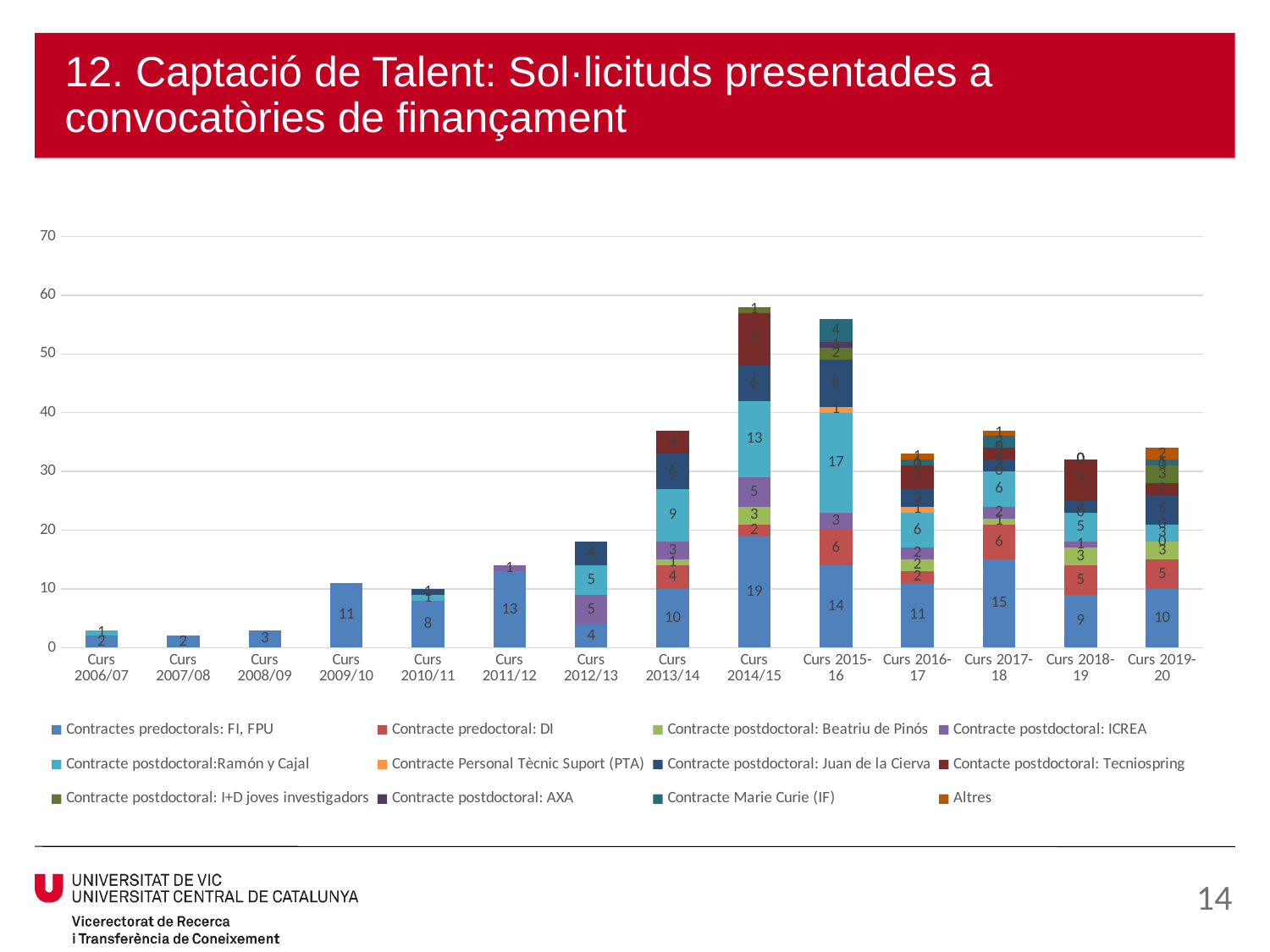
What is the value for 'Contracte postdoctoral:Ramón y Cajal' in Curs 2015-16? 17 Which academic year has the shortest stacked bar overall? Curs 2007/08 Is the total of the stacked bar for Curs 2013/14 greater or less than 30? greater What is the value for 'Contractes predoctorals: FI, FPU' in Curs 2014/15? 19 What is the value for 'Contractes predoctorals: FI, FPU' in Curs 2017-18? 15 What is the total of the stacked bar for Curs 2012/13? 18 What is the difference between the 'Contractes predoctorals: FI, FPU' values in Curs 2014/15 and Curs 2015-16? 5 Which is larger: the 'Contractes predoctorals: FI, FPU' value in Curs 2014/15 or in Curs 2015-16? Curs 2014/15 What type of chart is shown on the slide? Stacked bar chart How many academic years (categories) are shown on the x axis? 14 Which academic year has the tallest stacked bar overall? Curs 2014/15 How many series does the legend list? 12